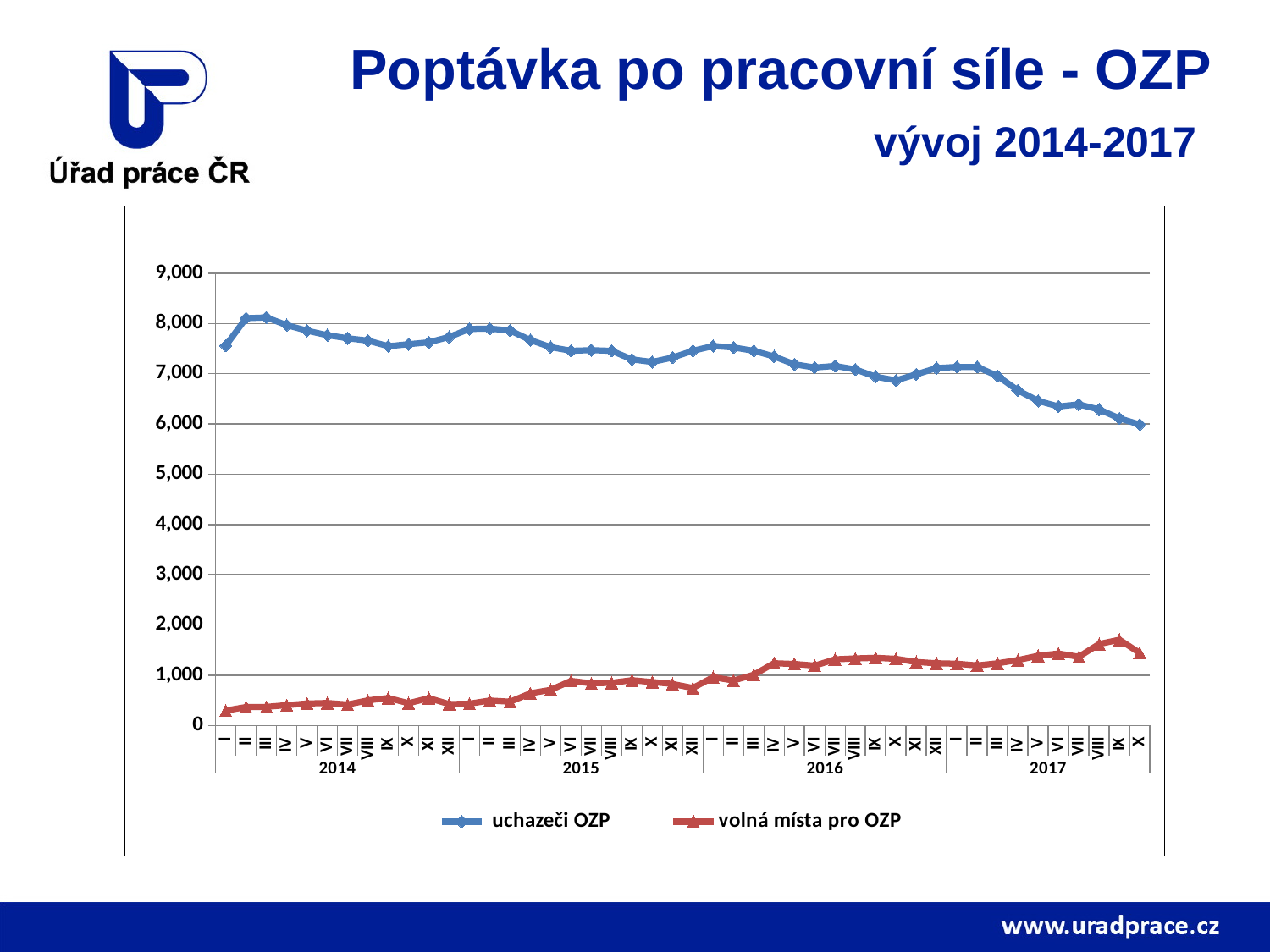
Is the value for volná místa pro OZP in IX 2017 greater or less than 2,000? less Does the uchazeči OZP series rise or fall overall from 2014 to 2017? fall What kind of chart is shown on the slide? line chart How many months are plotted for 2017? 10 What are the two series named in the legend? uchazeči OZP and volná místa pro OZP How many years are shown along the x axis? 4 Which series has the higher values throughout the chart, uchazeči OZP or volná místa pro OZP? uchazeči OZP Is the value for uchazeči OZP in I 2014 greater or less than 7,000? greater How many series does the legend list? 2 In which year does the volná místa pro OZP series reach its highest value? 2017 Does the volná místa pro OZP series rise or fall overall from 2014 to 2017? rise Is the value for volná místa pro OZP in I 2014 greater or less than 1,000? less